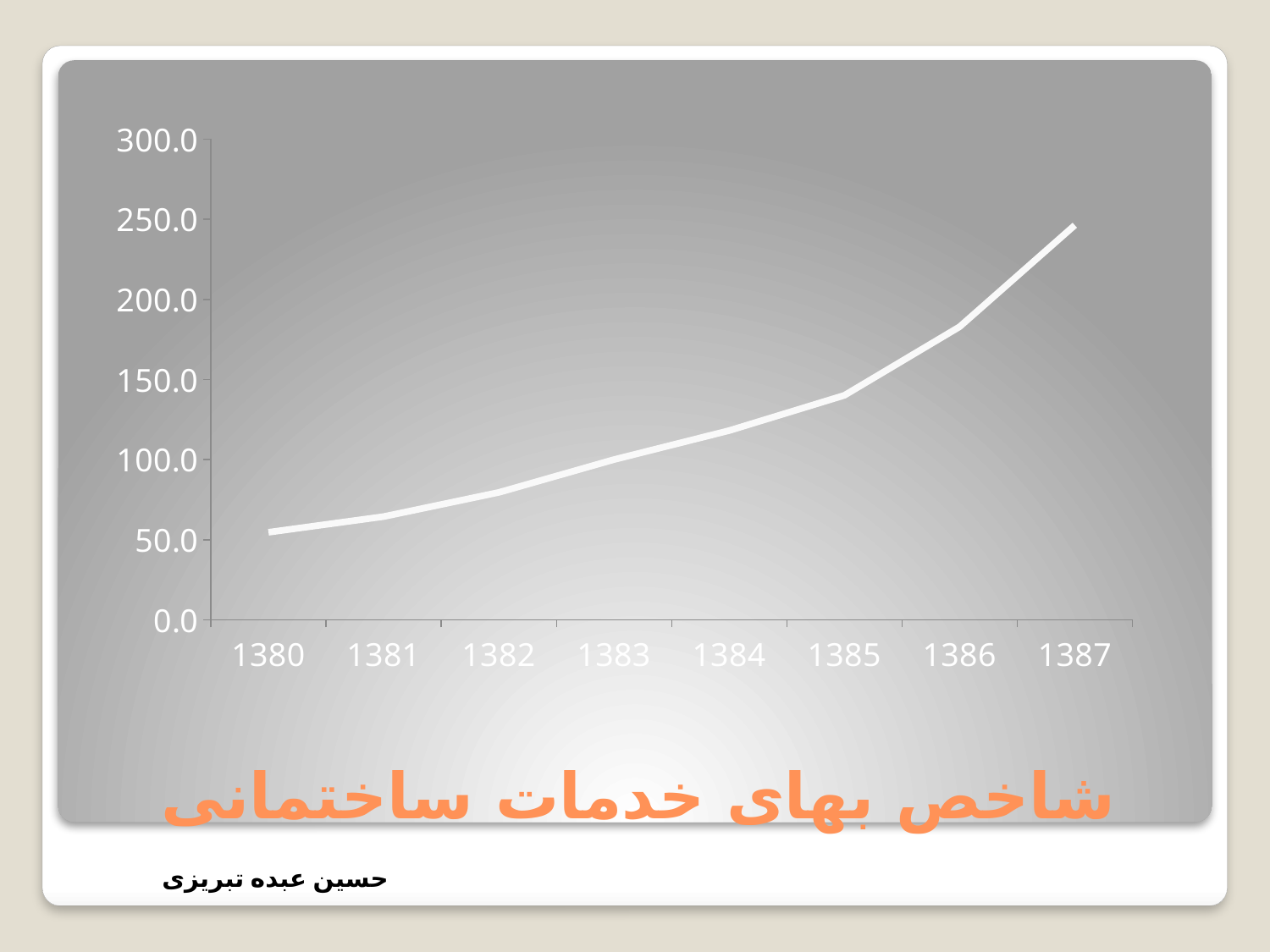
How many years are plotted along the x axis? 8 What is the highest tick value shown on the y axis? 300.0 Is the value for 1387 greater or less than 200.0? greater Is the value for 1380 greater or less than 100.0? less Is the value for 1382 greater or less than 100.0? less Do the values rise or fall from 1380 to 1387? rise Which is larger, the value for 1385 or the value for 1383? 1385 Which year has the lowest value? 1380 What is the first year shown on the x axis? 1380 What kind of chart is shown on the slide? line chart Which year has the highest value? 1387